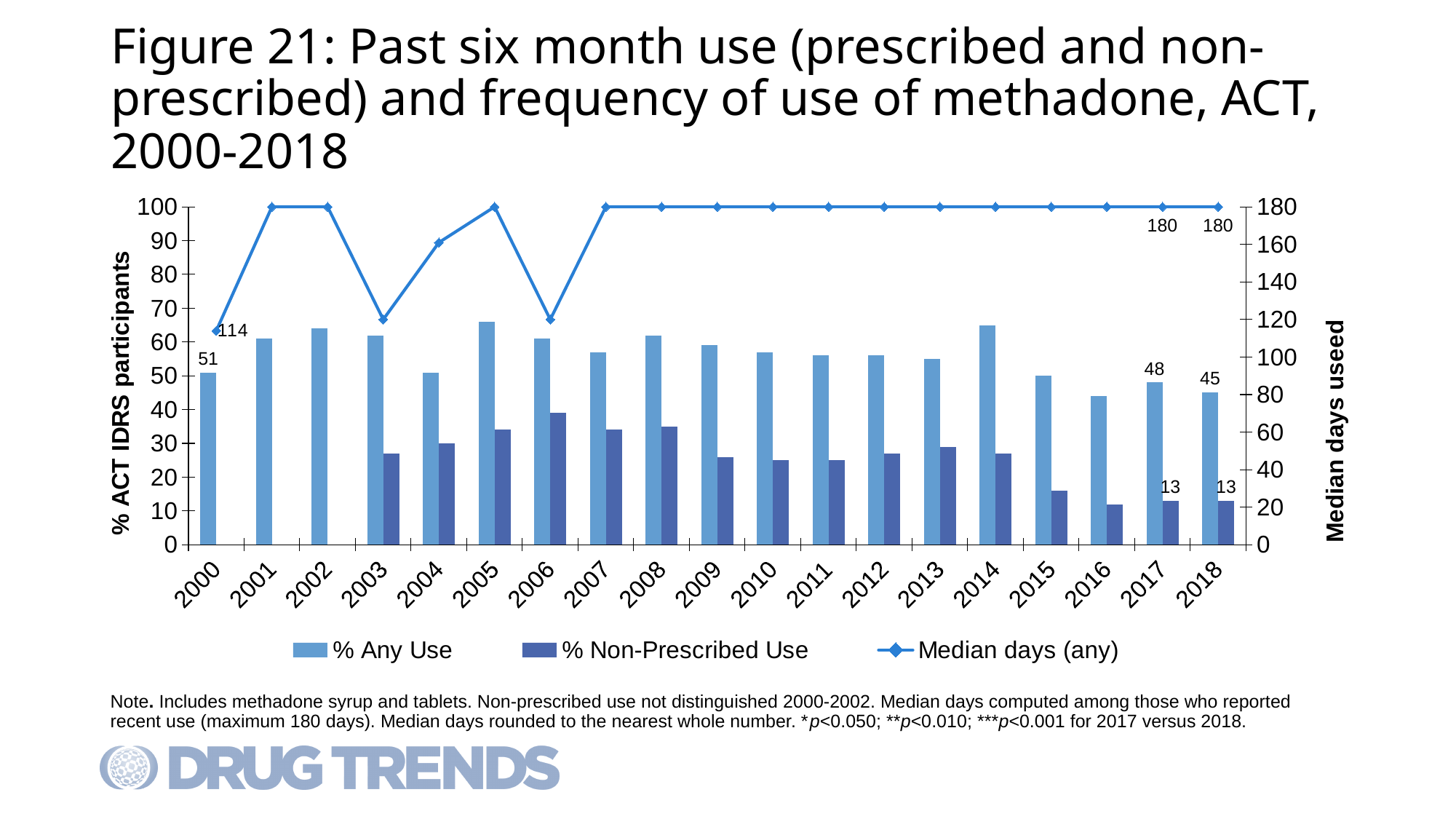
What kind of chart is this? Combined bar and line chart What is the Median days (any) value for 2000? 114 Is the % Any Use value for 2014 greater or less than 60? greater Which year has the higher % Any Use value, 2017 or 2018? 2017 How many series does the legend list? 3 What is the % Any Use value for 2017? 48 Is the % Non-Prescribed Use value for 2006 greater or less than 30? greater What is the % Any Use value for 2000? 51 What is the Median days (any) value for 2018? 180 How many years are shown on the x axis? 19 What is the % Non-Prescribed Use value for 2018? 13 What is the difference between the % Any Use values for 2017 and 2018? 3